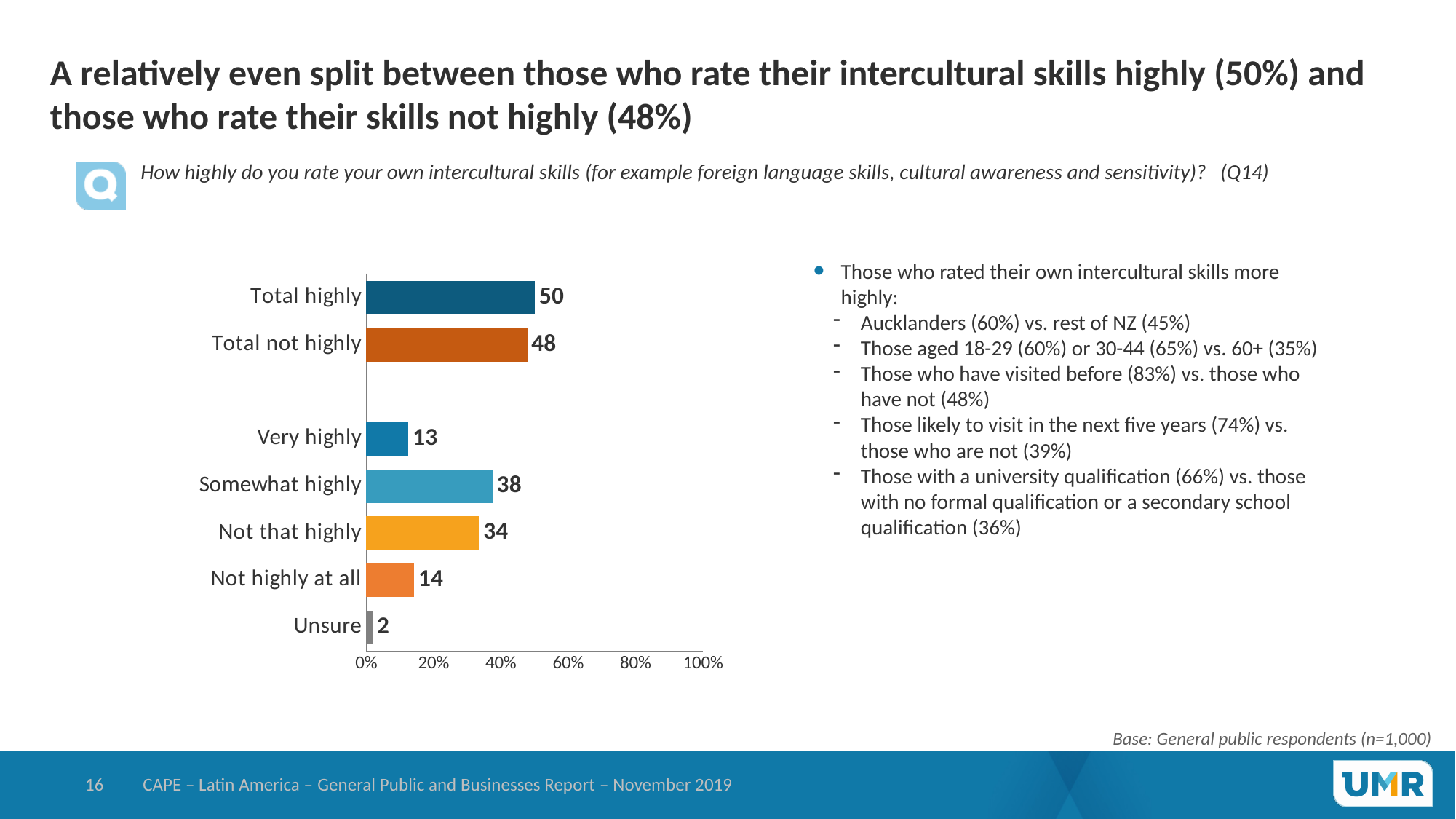
What is the difference between Total highly and Total not highly? 2 What is the difference between Somewhat highly and Not that highly? 4 What is the value for Unsure? 2 What kind of chart is shown on the slide? bar chart Which category has the highest value? Total highly How many categories are shown in the chart? 7 What is the value for Somewhat highly? 38 What is the value for Total highly? 50 Which is larger, Very highly or Not highly at all? Not highly at all Which category has the lowest value? Unsure What is the value for Not highly at all? 14 Is the value for Not that highly greater or less than 40%? less